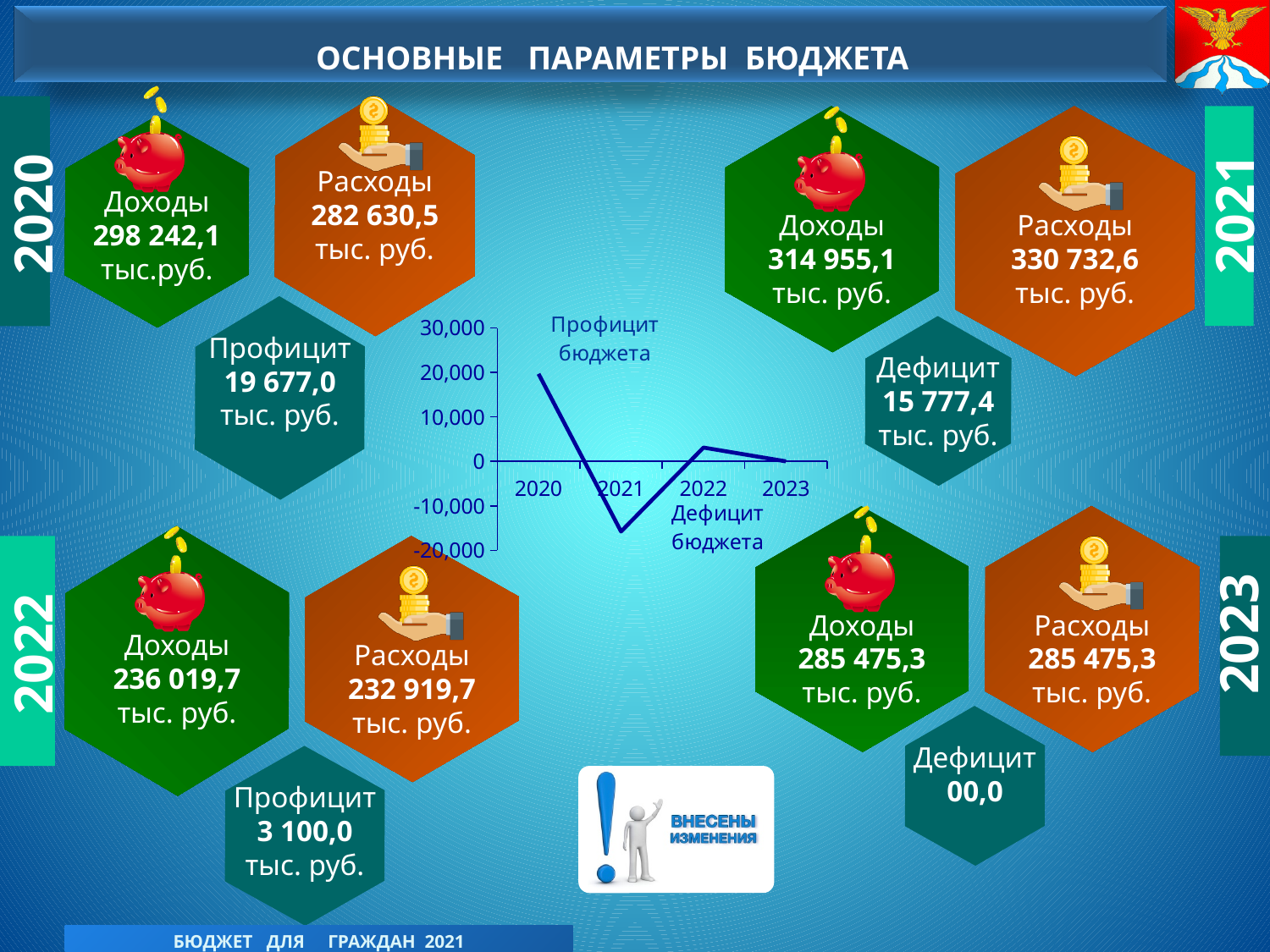
How many years are plotted along the x axis of the line chart? 4 Which year has the lowest value on the line chart? 2021 Does the line rise or fall from 2020 to 2021? fall What kind of chart is shown in the centre of the slide? line chart Is the value for 2022 on the line chart greater or less than 10,000? less Which year has the larger value on the line chart, 2020 or 2022? 2020 Does the line rise or fall from 2021 to 2022? rise Is the value for 2021 on the line chart greater or less than -10,000? less Is the value for 2020 on the line chart greater or less than 10,000? greater Which year has the highest value on the line chart? 2020 What is the highest tick value shown on the y axis of the line chart? 30,000